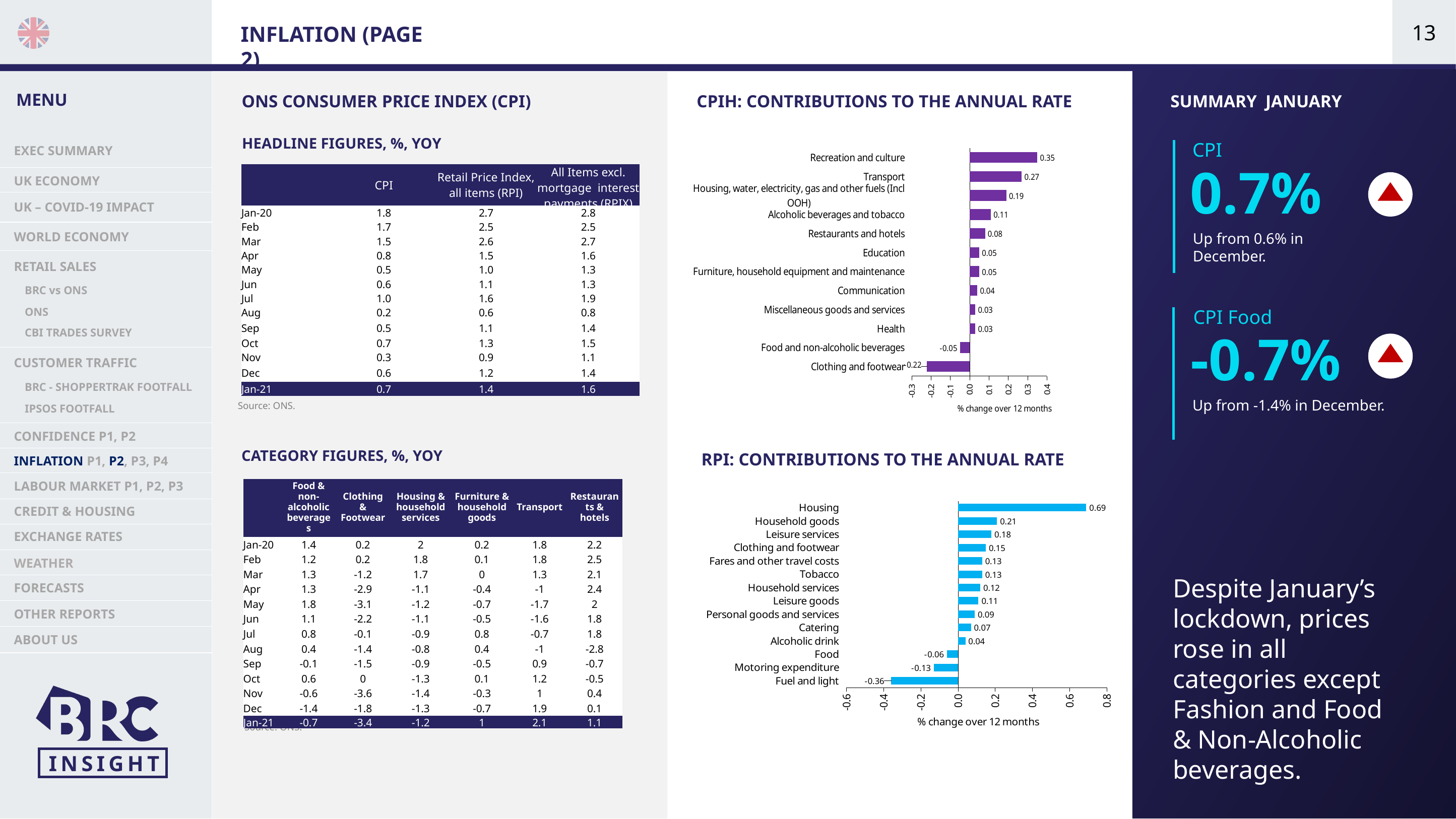
In the 'RPI: Contributions to the annual rate' chart, which category has the lowest value? Fuel and light In the 'CPIH: Contributions to the annual rate' chart, which category has the lowest value? Clothing and footwear In the 'RPI: Contributions to the annual rate' chart, what is the value for Housing? 0.69 In the 'CPIH: Contributions to the annual rate' chart, what is the value for Food and non-alcoholic beverages? -0.05 In the 'CPIH: Contributions to the annual rate' chart, what is the difference between the values for Recreation and culture and Transport? 0.08 What is the x-axis label of the 'RPI: Contributions to the annual rate' chart? % change over 12 months In the 'RPI: Contributions to the annual rate' chart, what is the value for Motoring expenditure? -0.13 In the 'CPIH: Contributions to the annual rate' chart, what is the value for Recreation and culture? 0.35 What kind of chart is 'CPIH: Contributions to the annual rate'? Bar chart In the 'RPI: Contributions to the annual rate' chart, how many categories are shown? 14 In the 'RPI: Contributions to the annual rate' chart, which is larger, the value for Household goods or the value for Leisure services? Household goods In the 'CPIH: Contributions to the annual rate' chart, how many categories are shown? 12